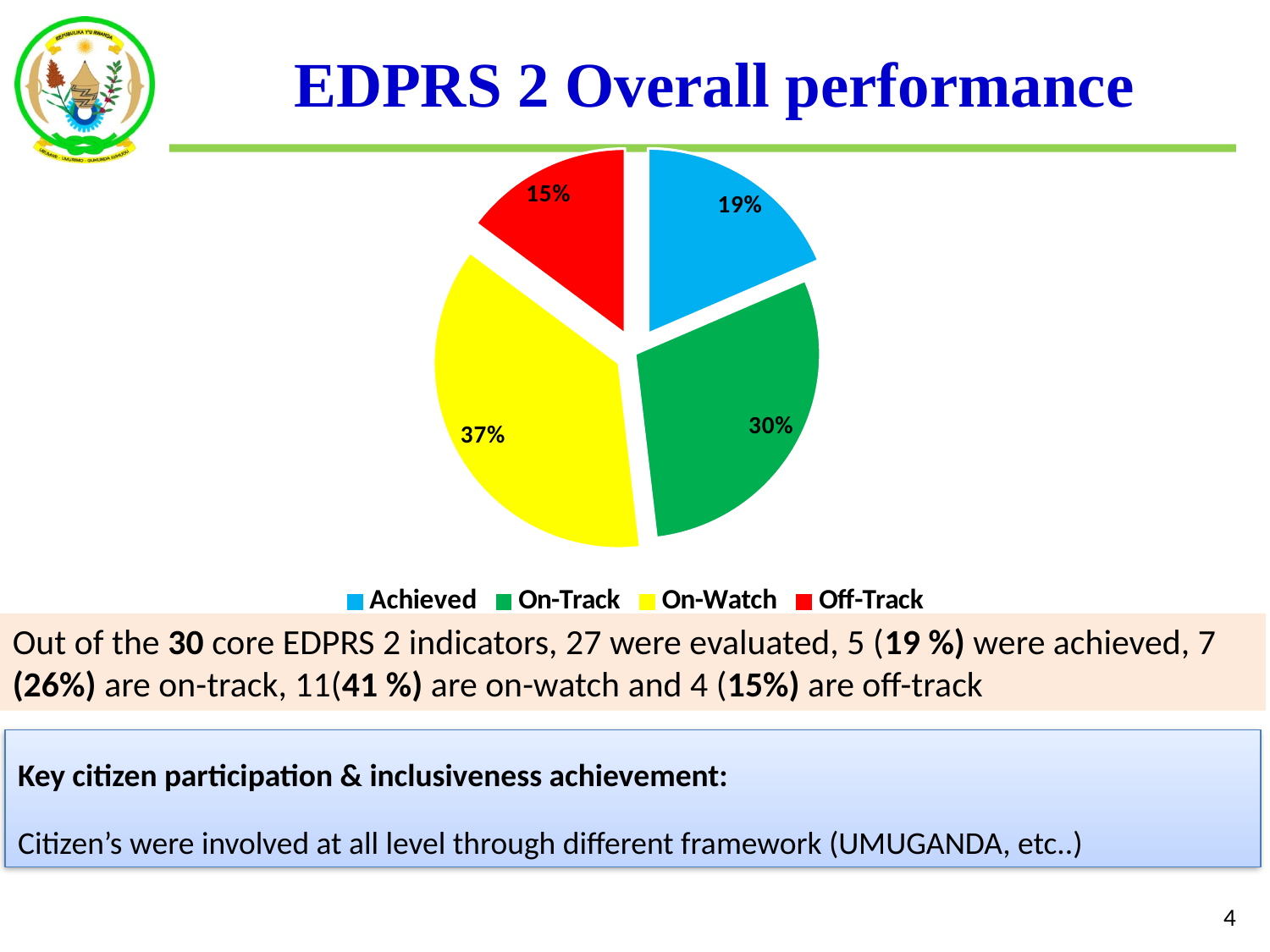
Which category has the largest share of the pie? On-Watch What percentage is shown for the On-Track slice? 30% What colour is the On-Watch slice? yellow What is the difference in percentage points between the On-Watch and Off-Track slices? 22 What is the title of the slide containing the pie chart? EDPRS 2 Overall performance What type of chart is shown on the slide? pie chart What percentage of the pie is labelled for the Achieved slice? 19% What percentage is shown for the Off-Track slice? 15% What percentage is shown for the On-Watch slice? 37% How many categories does the legend list? 4 Which slice is larger, Achieved or On-Track? On-Track Which category has the smallest share of the pie? Off-Track